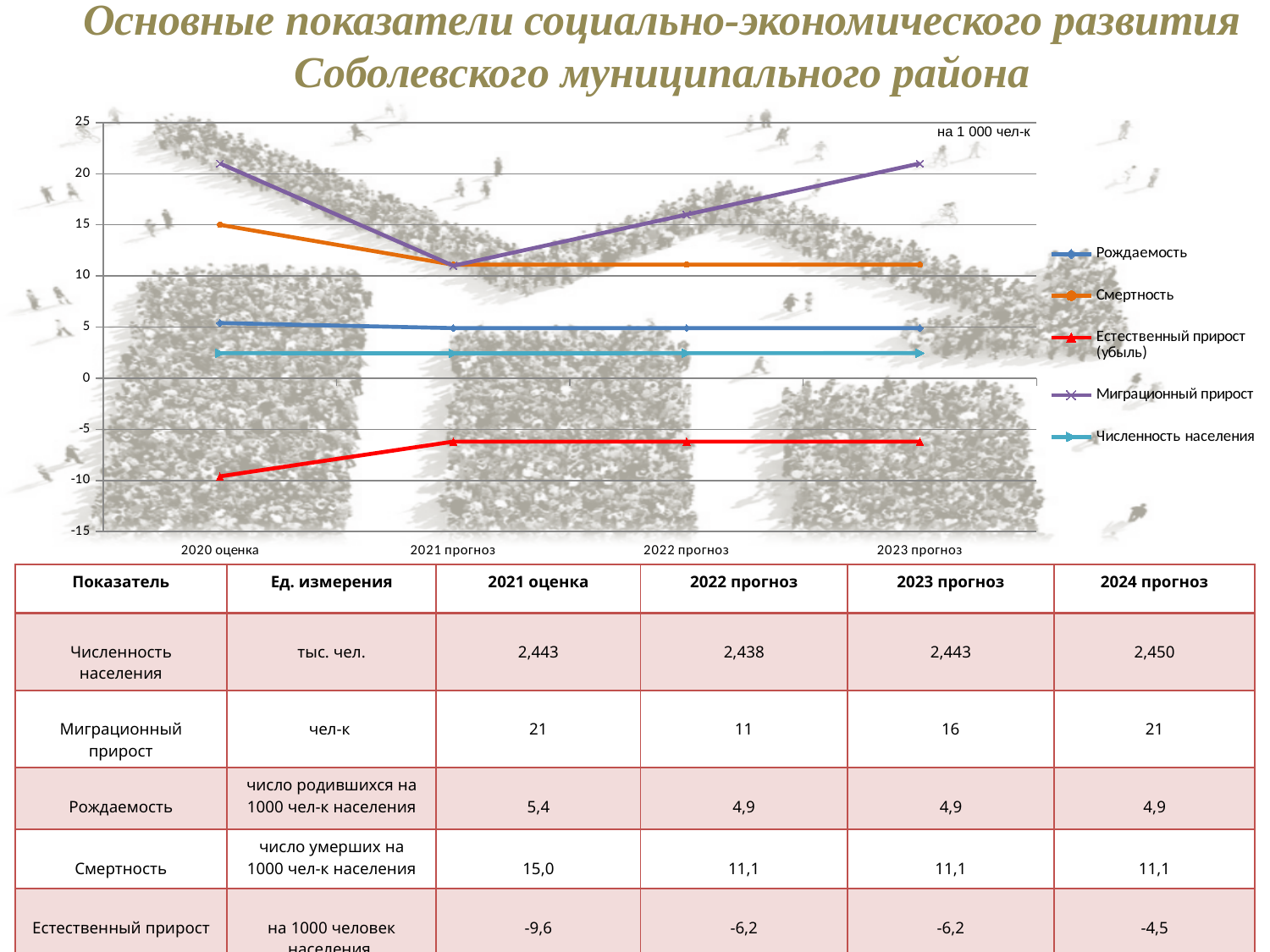
At 2022 прогноз, which is larger: Смертность or Рождаемость? Смертность Which series has the lowest value at 2020 оценка? Естественный прирост (убыль) Is the value for Смертность at 2020 оценка greater or less than 10? greater What unit note is printed in the top right corner of the chart area? на 1 000 чел-к Is the value for Миграционный прирост at 2020 оценка greater or less than 15? greater Is the value for Численность населения at 2023 прогноз greater or less than 5? less Which series has the highest value at 2020 оценка? Миграционный прирост How many series does the chart legend list? 5 Does the Миграционный прирост line rise or fall from 2021 прогноз to 2023 прогноз? rises How many categories are shown along the x axis of the chart? 4 What kind of chart is shown on the slide? line chart